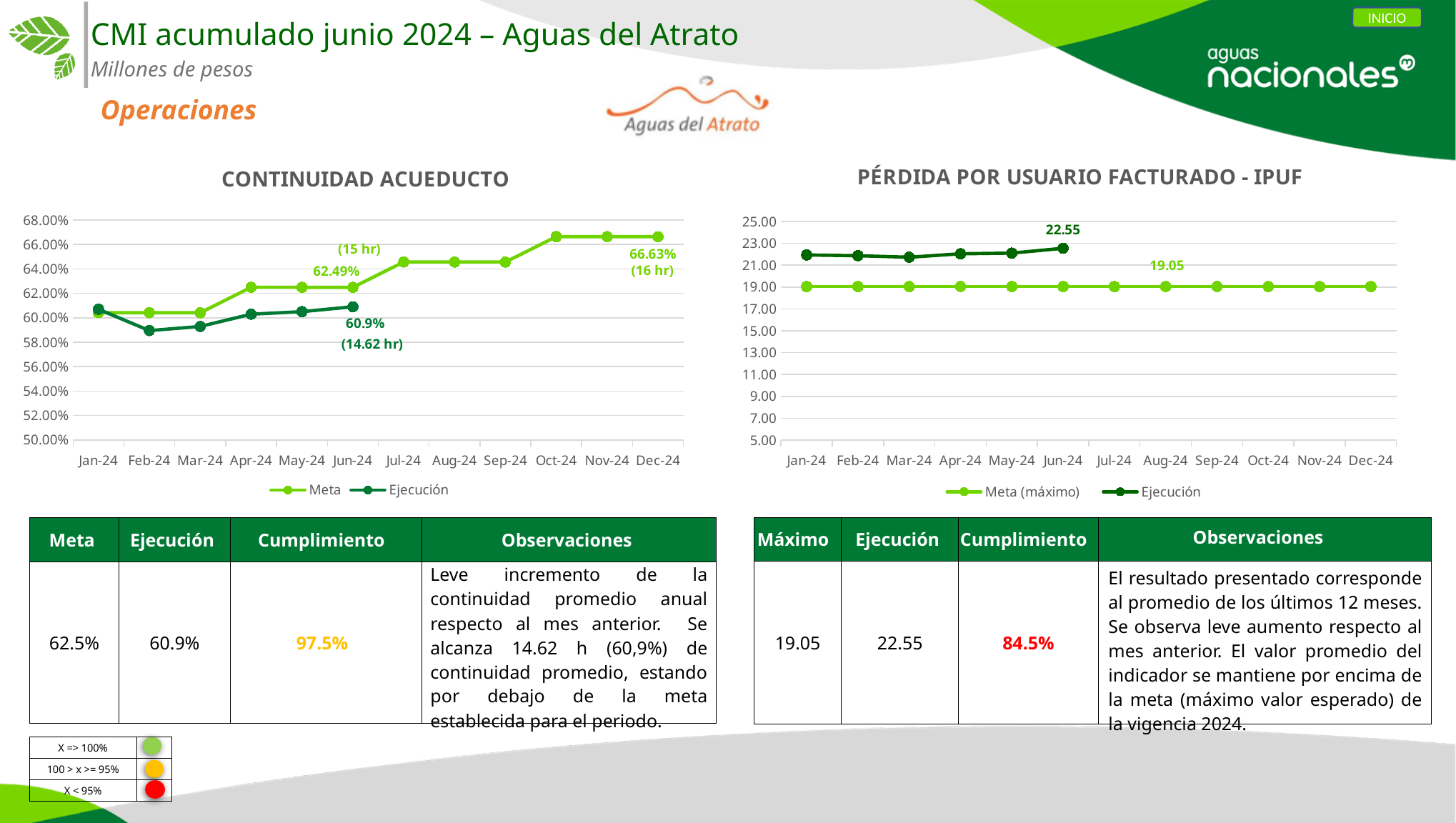
In the CONTINUIDAD ACUEDUCTO chart, how many months are shown on the x axis? 12 In the PÉRDIDA POR USUARIO FACTURADO - IPUF chart, which is larger at Jun-24, Ejecución or Meta (máximo)? Ejecución In the CONTINUIDAD ACUEDUCTO chart, what is the labelled Ejecución value for Jun-24? 60.9% In the CONTINUIDAD ACUEDUCTO chart, what is the labelled Meta value for Dec-24? 66.63% In the CONTINUIDAD ACUEDUCTO chart, what is the labelled Meta value for Jun-24? 62.49% In the CONTINUIDAD ACUEDUCTO chart, how many series does the legend list? 2 In the PÉRDIDA POR USUARIO FACTURADO - IPUF chart, what is the labelled Ejecución value for Jun-24? 22.55 In the PÉRDIDA POR USUARIO FACTURADO - IPUF chart, what is the labelled Meta (máximo) value? 19.05 In the CONTINUIDAD ACUEDUCTO chart, is the Ejecución value for Feb-24 greater or less than 60.00%? less In the PÉRDIDA POR USUARIO FACTURADO - IPUF chart, what is the difference between the Jun-24 Ejecución value and the Meta (máximo) value? 3.50 In the CONTINUIDAD ACUEDUCTO chart, does the Meta series rise or fall from Jan-24 to Dec-24? rise What kind of chart is the CONTINUIDAD ACUEDUCTO chart? line chart